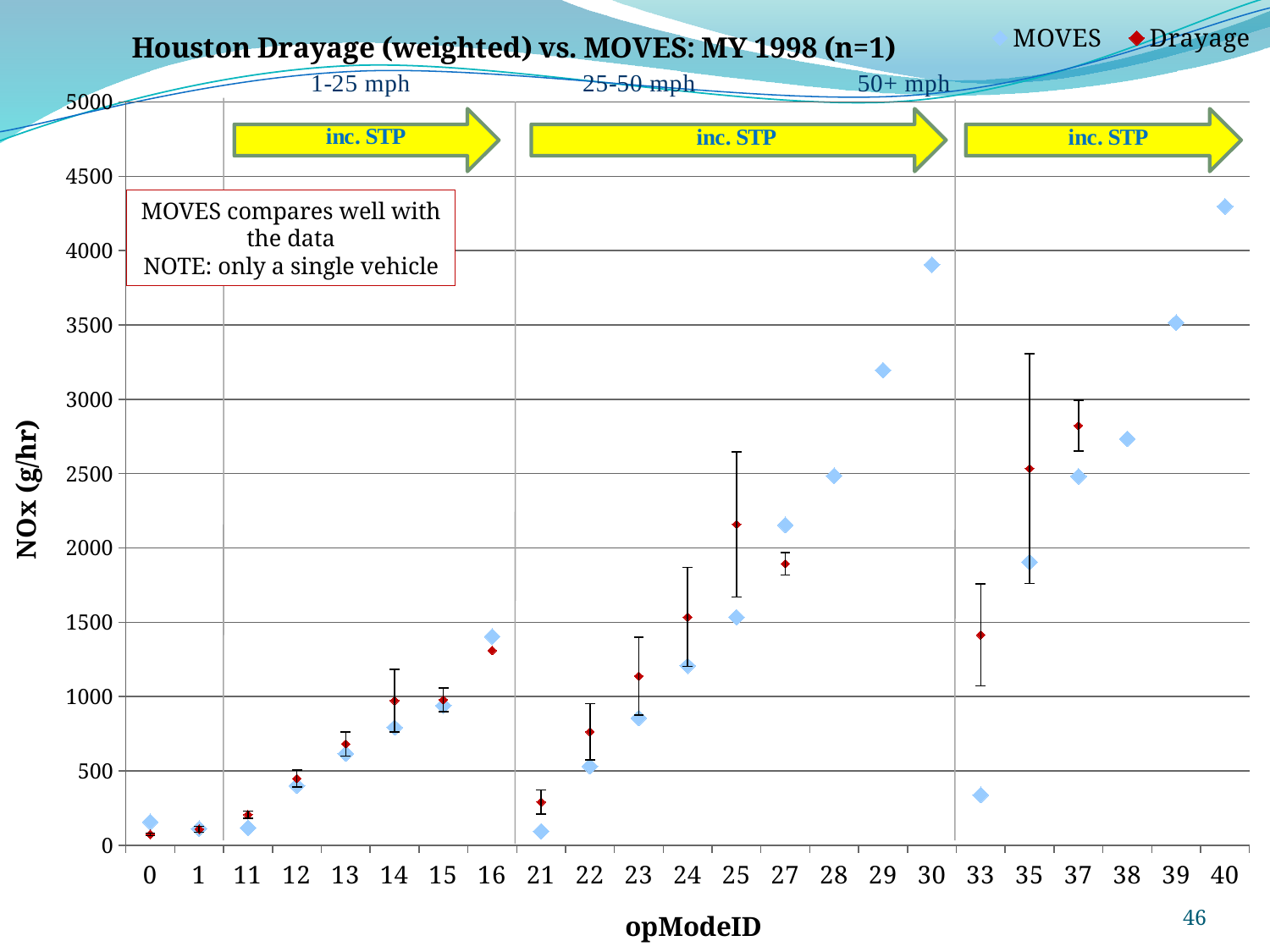
Is the MOVES value for opModeID 33 greater or less than 500? less Which opModeID has the highest MOVES value? 40 At opModeID 33, which series has the larger value, MOVES or Drayage? Drayage Is the Drayage value for opModeID 21 greater or less than 500? less Is the MOVES value for opModeID 40 greater or less than 4000? greater What is the label of the y axis? NOx (g/hr) How many opModeID categories are shown on the x axis? 23 What kind of chart is shown on the slide? scatter chart At opModeID 25, which series has the larger value, MOVES or Drayage? Drayage What are the two series named in the legend? MOVES and Drayage How many series does the legend list? 2